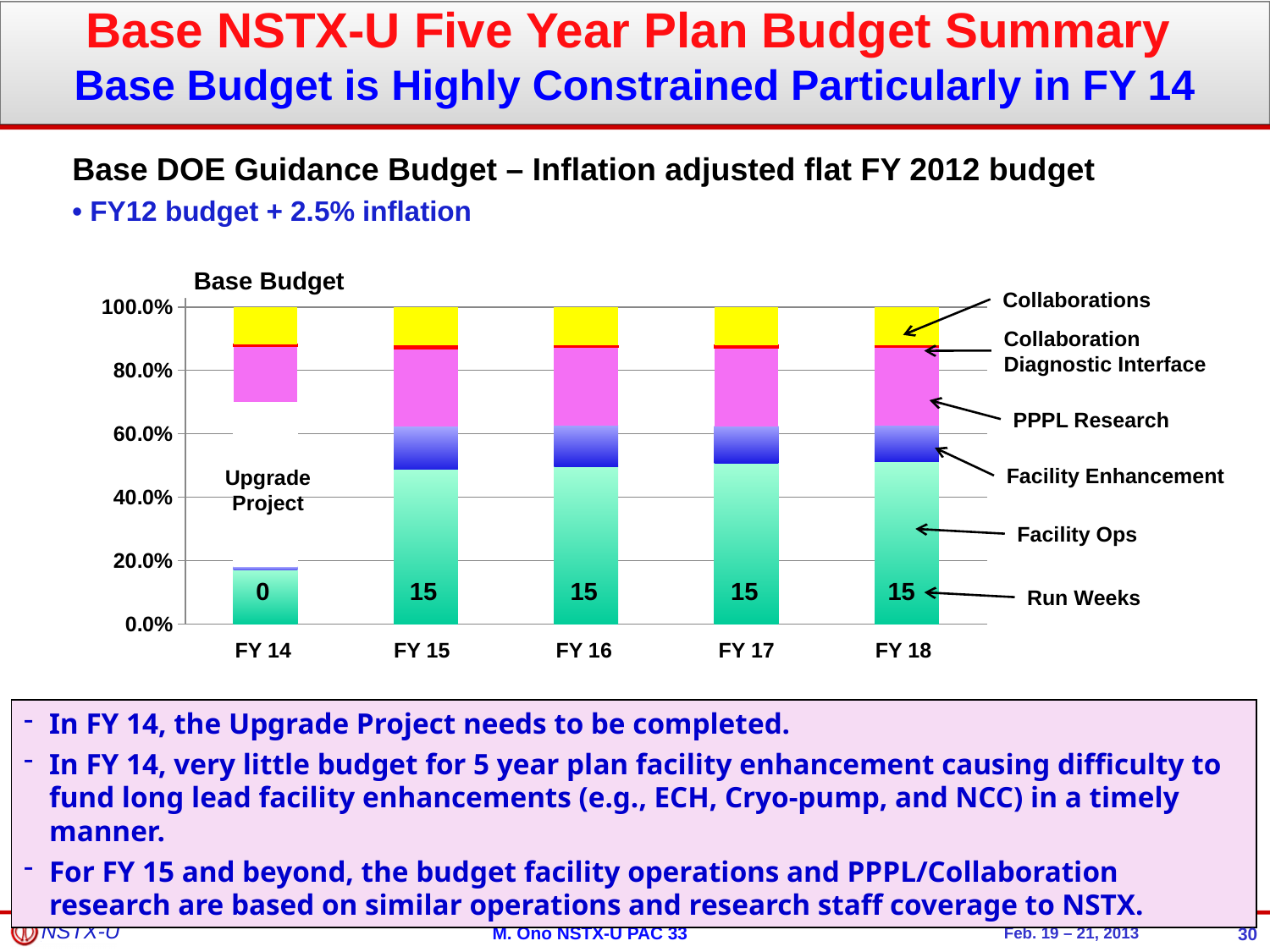
How many run weeks are labelled on the FY 14 bar? 0 What label is written in the gap of the FY 14 bar? Upgrade Project What is the highest value shown on the y axis? 100.0% Which has more run weeks, FY 14 or FY 17? FY 17 What is the title of the chart? Base Budget What is the difference in run weeks between FY 15 and FY 14? 15 Which fiscal year has the lowest number of run weeks? FY 14 How many run weeks are labelled on the FY 16 bar? 15 How many fiscal years are shown on the x axis of the Base Budget chart? 5 What kind of chart is shown on the slide? stacked bar chart Is the Facility Ops share in FY 18 greater or less than 40.0%? greater Is the Facility Ops share in FY 14 greater or less than 20.0%? less